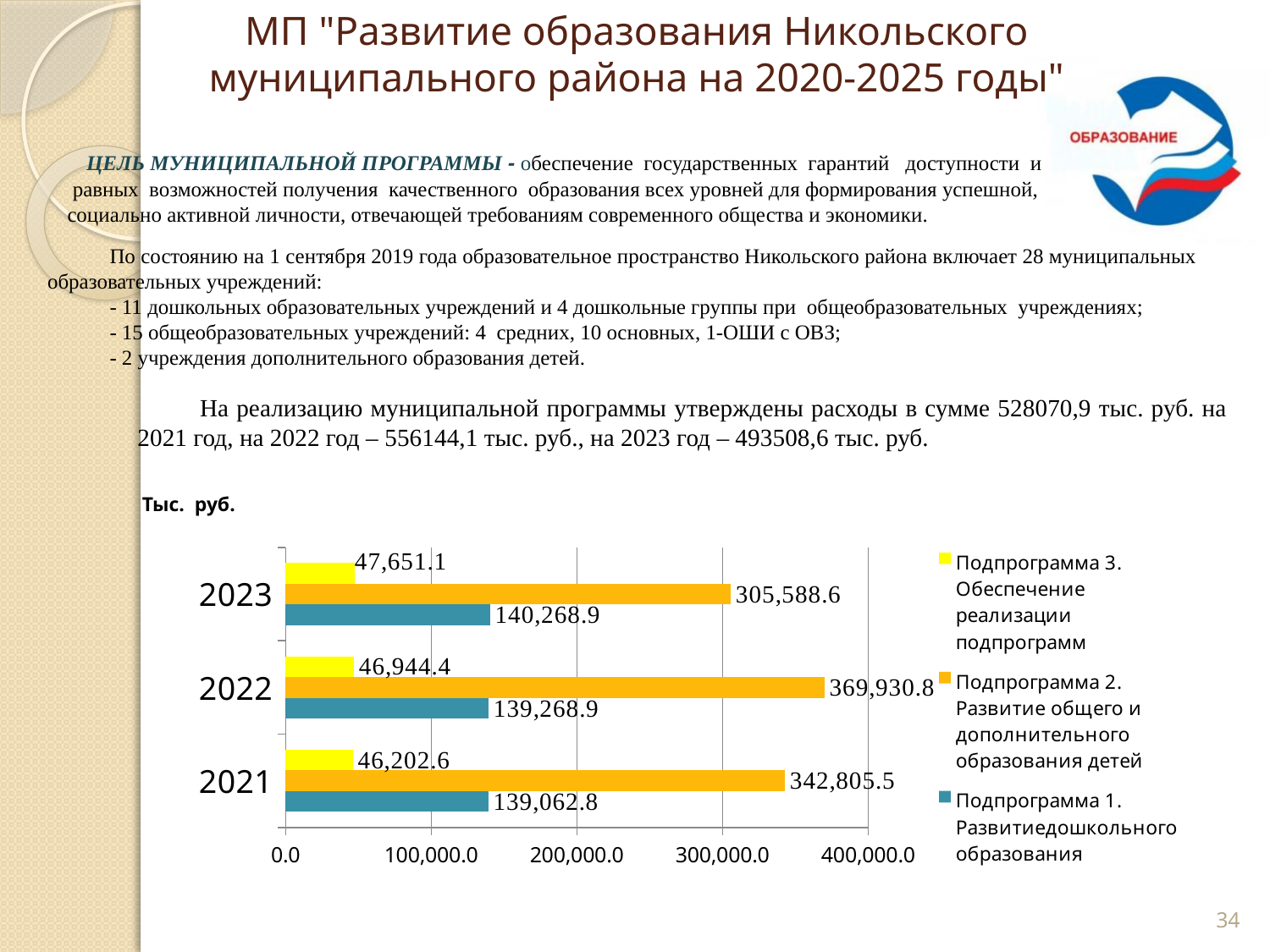
How many years are shown on the chart? 3 What is the value for Подпрограмма 1 in 2023? 140,268.9 In which year is the value for Подпрограмма 2 the highest? 2022 What kind of chart is shown on the slide? bar chart What is the difference between the Подпрограмма 1 values for 2023 and 2022? 1,000.0 Is the value for Подпрограмма 2 in 2023 greater or less than 300,000.0? greater In which year is the value for Подпрограмма 2 the lowest? 2023 What is the difference between the Подпрограмма 2 values for 2022 and 2021? 27,125.3 Which is larger: the value for Подпрограмма 1 in 2021 or the value for Подпрограмма 3 in 2021? Подпрограмма 1 in 2021 What is the value for Подпрограмма 2 in 2022? 369,930.8 What is the value for Подпрограмма 3 in 2021? 46,202.6 How many series does the legend list? 3